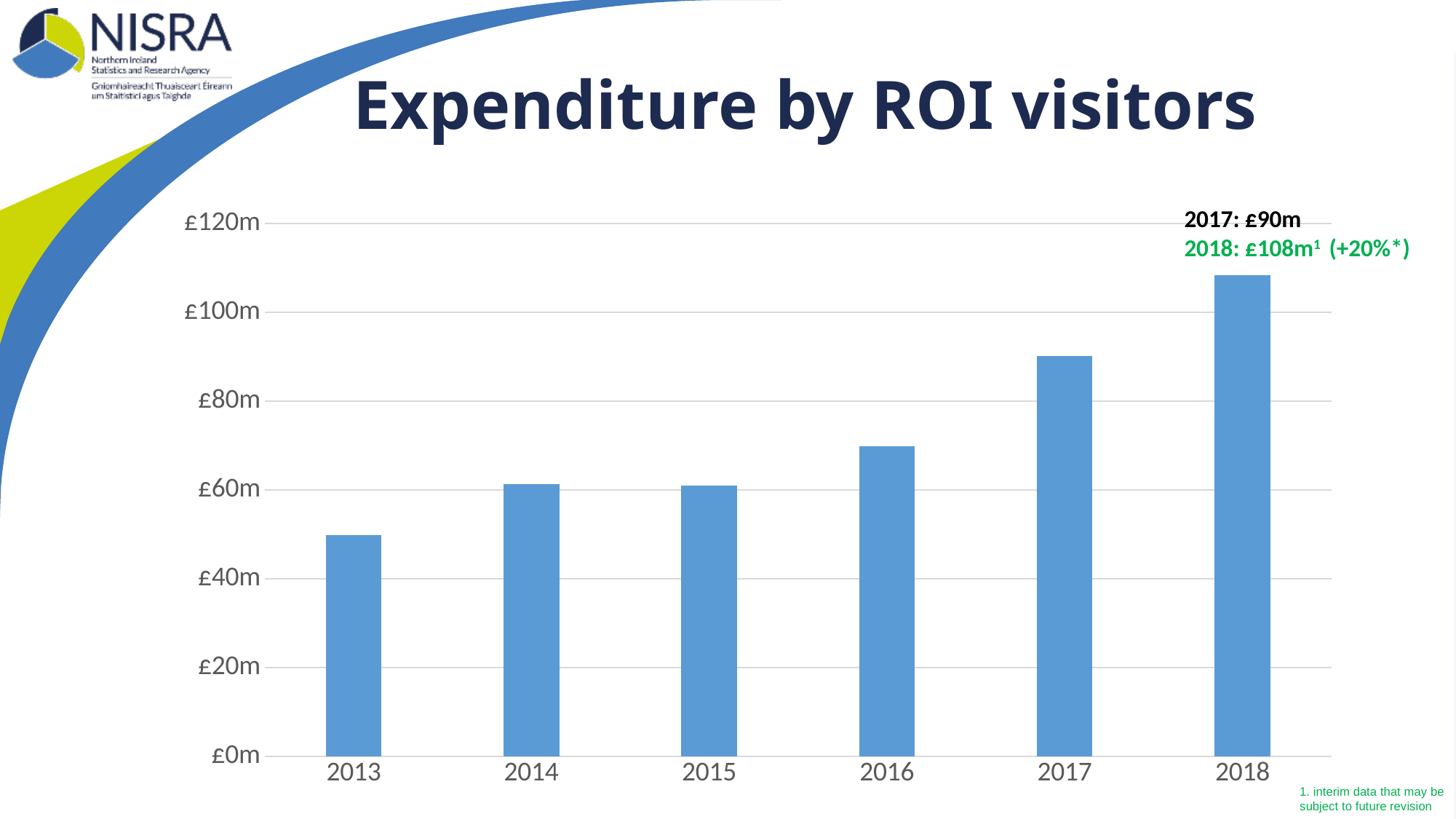
Which year has the highest expenditure by ROI visitors? 2018 What was the expenditure by ROI visitors in 2017? £90m Is the expenditure for 2014 greater or less than £80m? less By how much did expenditure by ROI visitors increase from 2017 to 2018? £18m What type of chart is used to show expenditure by ROI visitors? Bar chart What was the expenditure by ROI visitors in 2018? £108m Which year has the lowest expenditure by ROI visitors? 2013 How many years are shown on the chart? 6 What is the overall trend in expenditure by ROI visitors from 2013 to 2018? Rising Is the expenditure for 2013 greater or less than £40m? greater Is the expenditure for 2016 greater or less than £80m? less Which year had higher expenditure by ROI visitors, 2013 or 2016? 2016